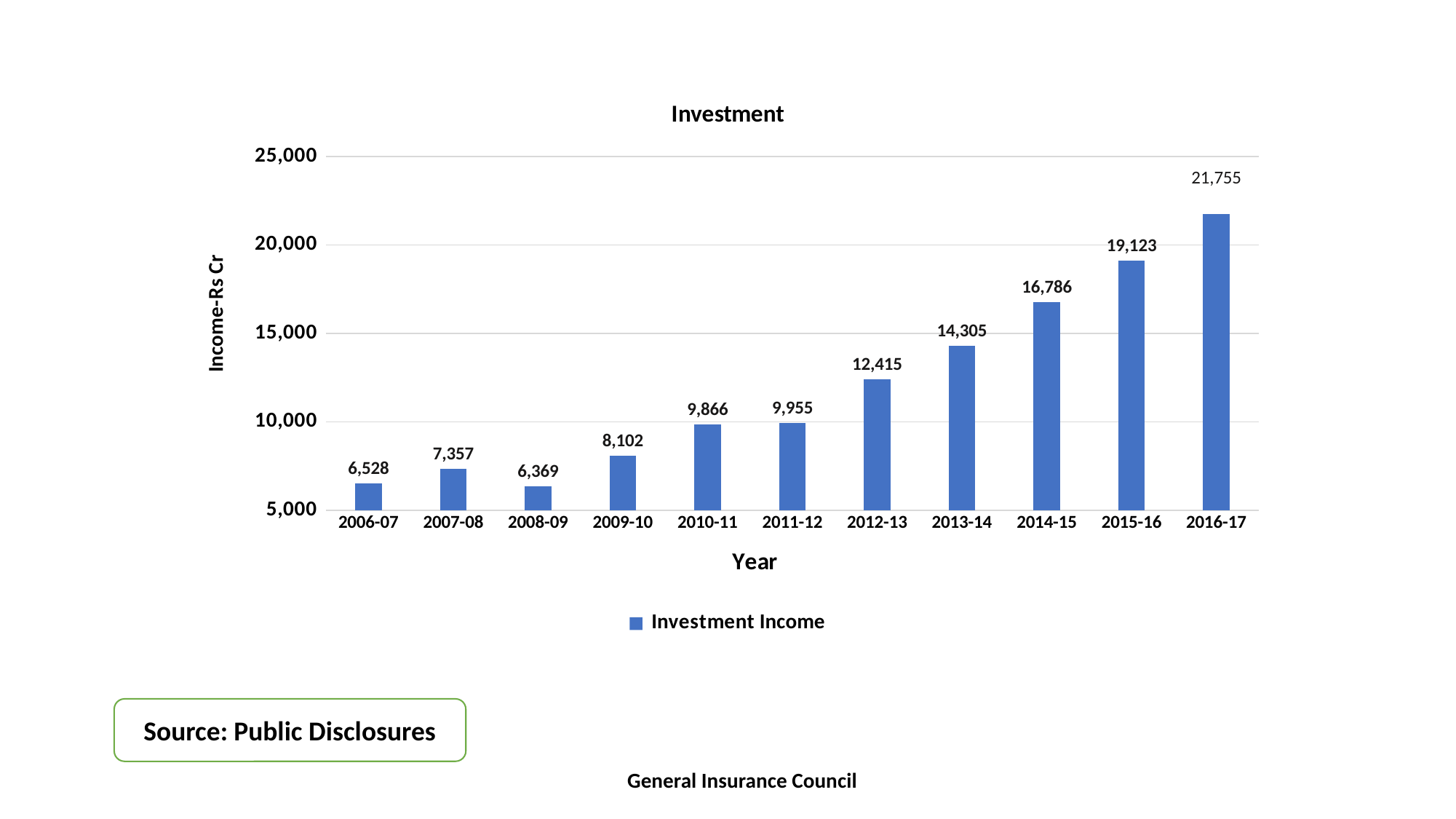
Is the investment income for 2013-14 greater or less than 15,000? less What is the difference in investment income between 2007-08 and 2006-07? 829 Which year has the lowest investment income? 2008-09 How many series does the legend list? 1 Which year has the highest investment income? 2016-17 What is the investment income for 2014-15? 16,786 What is the title of the chart? Investment How many years are shown on the x axis? 11 What kind of chart is shown on the slide? Bar chart What is the difference in investment income between 2016-17 and 2015-16? 2,632 What is the investment income for 2010-11? 9,866 Which year has a larger investment income, 2009-10 or 2012-13? 2012-13